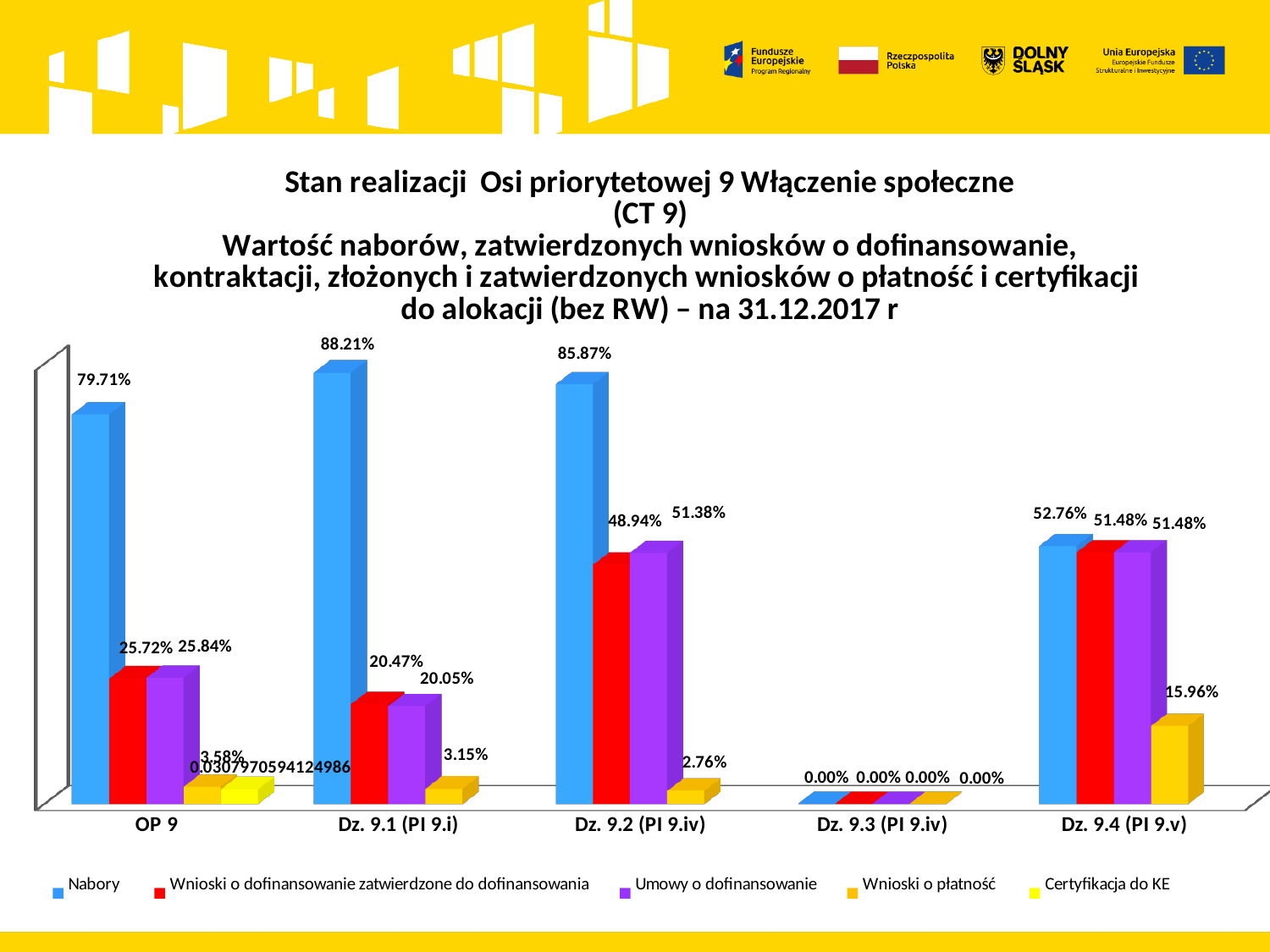
What is the value of Nabory for OP 9? 79.71% Which category has the highest Nabory value? Dz. 9.1 (PI 9.i) Which is larger for Dz. 9.2 (PI 9.iv): Nabory or Umowy o dofinansowanie? Nabory What is the difference between Umowy o dofinansowanie and Wnioski o dofinansowanie zatwierdzone do dofinansowania for Dz. 9.2 (PI 9.iv)? 2.44% What is the difference between Nabory and Wnioski o płatność for Dz. 9.4 (PI 9.v)? 36.80% Which category has the lowest Nabory value? Dz. 9.3 (PI 9.iv) What kind of chart is shown on the slide? bar chart What is the value of Nabory for Dz. 9.1 (PI 9.i)? 88.21% How many categories are shown on the x axis? 5 What is the value of Wnioski o płatność for Dz. 9.4 (PI 9.v)? 15.96% How many series does the legend list? 5 What is the value of Umowy o dofinansowanie for Dz. 9.2 (PI 9.iv)? 51.38%